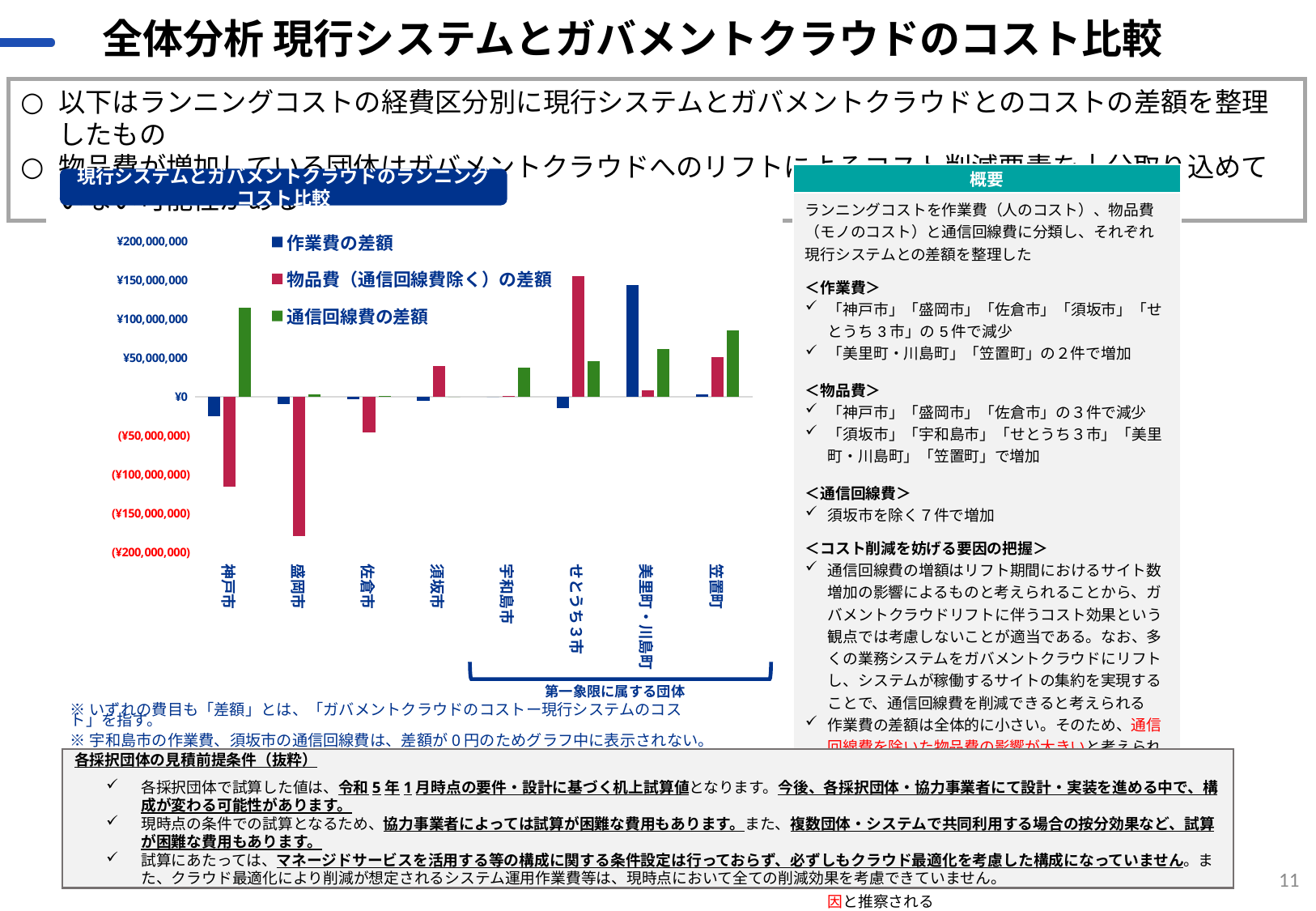
What kind of chart is shown on the slide? bar chart What colour represents the 通信回線費の差額 series in the chart? green How many municipalities (categories) are shown on the x axis of the chart? 8 How many series does the chart legend list? 3 Is the 物品費（通信回線費除く）の差額 value for 盛岡市 greater or less than (¥150,000,000)? less Is the 作業費の差額 value for 美里町・川島町 greater or less than ¥100,000,000? greater Which category has the highest 作業費の差額 bar? 美里町・川島町 Which category has the highest 通信回線費の差額 bar? 神戸市 Which is larger: the 通信回線費の差額 for 神戸市 or for 笠置町? 神戸市 Which category has the highest 物品費（通信回線費除く）の差額 bar? せとうち３市 Which category has the lowest 物品費（通信回線費除く）の差額 bar? 盛岡市